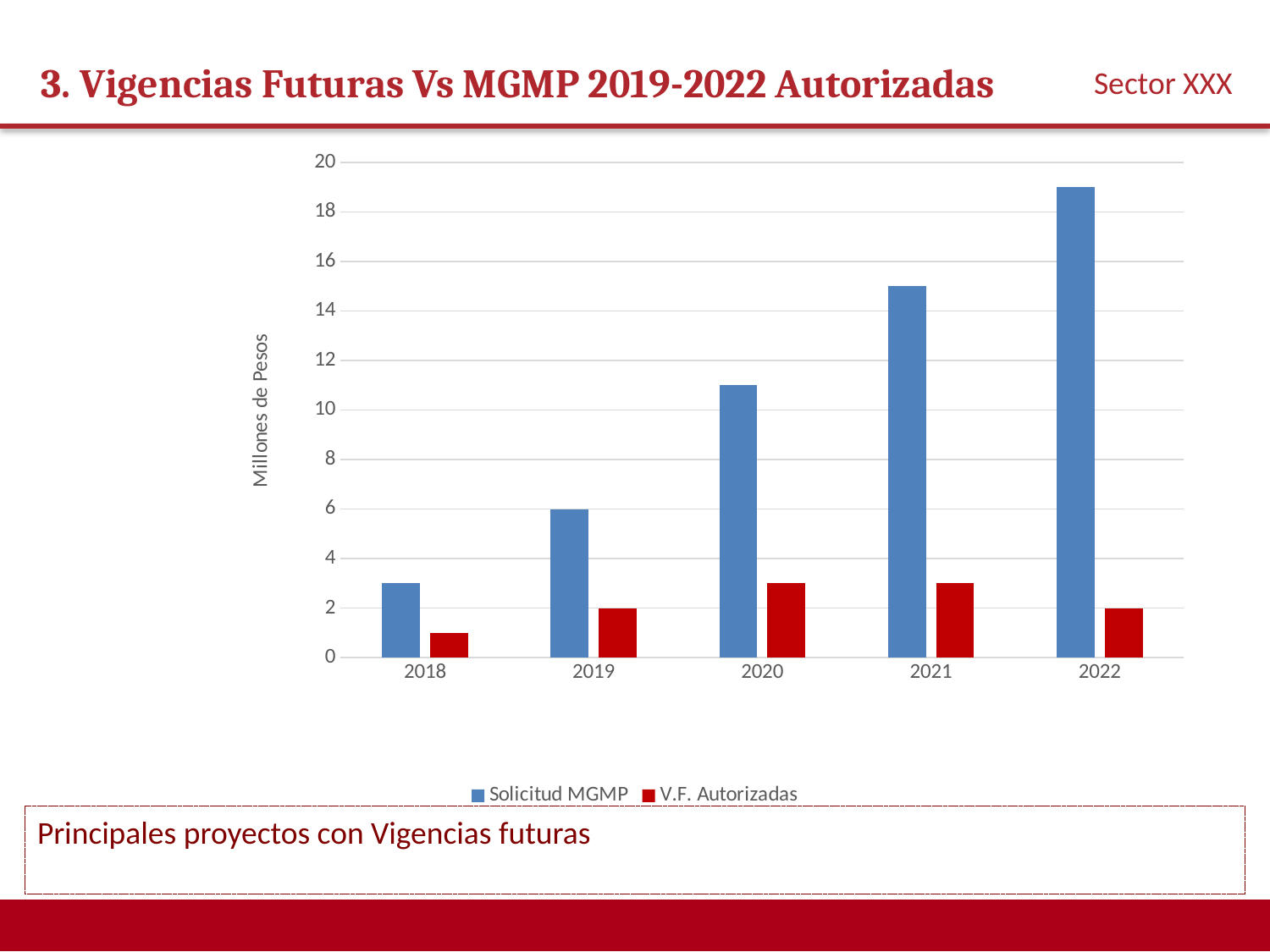
Is the value of Solicitud MGMP for 2020 greater or less than 12? less What is the value of Solicitud MGMP for 2019? 6 Do the Solicitud MGMP values rise or fall from 2018 to 2022? rise Which year has the highest Solicitud MGMP value? 2022 What is the value of V.F. Autorizadas for 2022? 2 How many series does the legend list? 2 Which year has the lowest V.F. Autorizadas value? 2018 How many years are shown on the x axis? 5 What kind of chart is shown on the slide? bar chart Which is larger in 2021, Solicitud MGMP or V.F. Autorizadas? Solicitud MGMP Is the value of Solicitud MGMP for 2022 greater or less than 18? greater What is the value of V.F. Autorizadas for 2019? 2